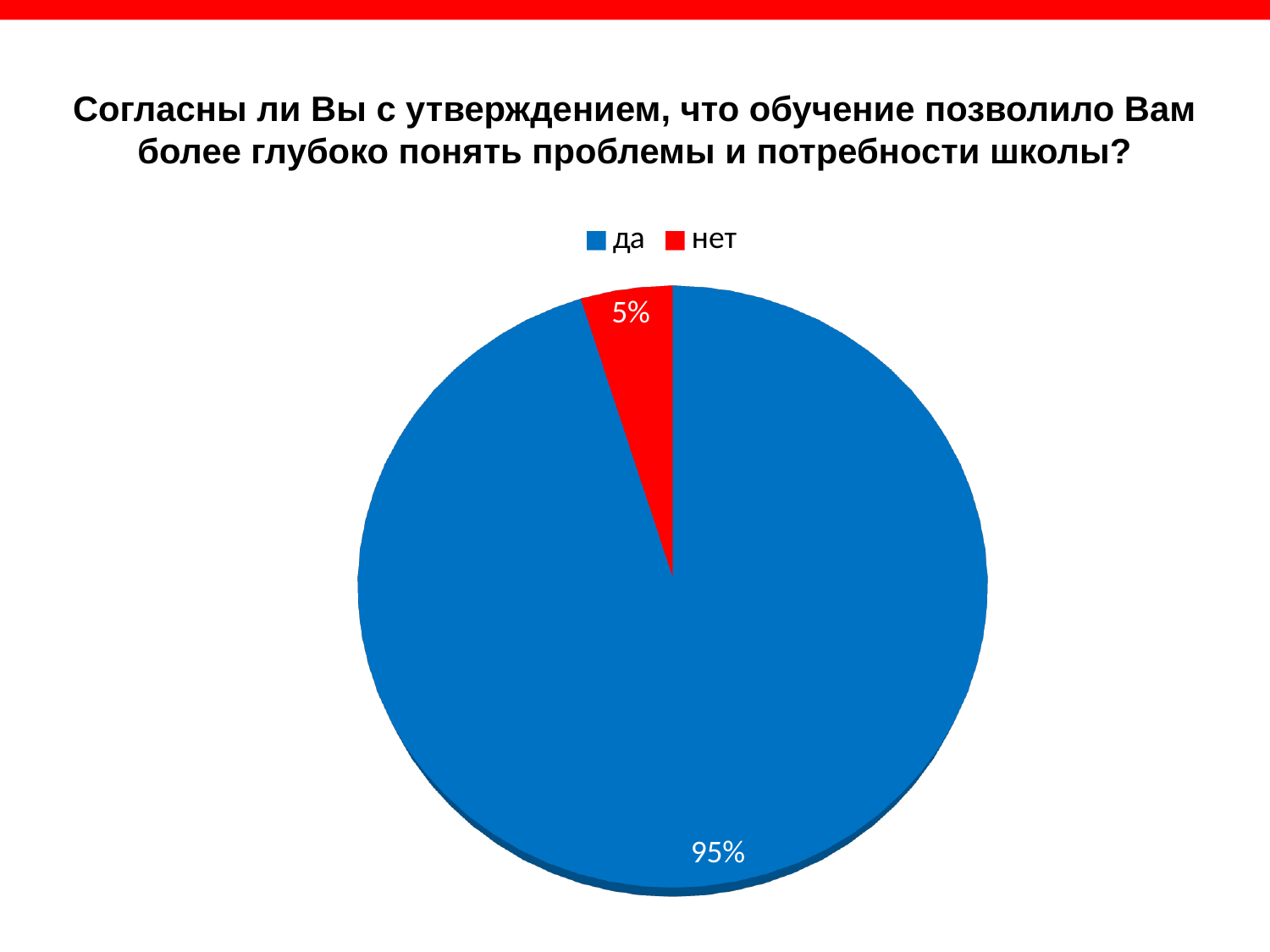
How many categories does the pie chart show? 2 What colour is the "нет" slice? red Which category has the smallest slice of the pie? нет What is the difference in percentage points between the "да" and "нет" slices? 90 What share of the pie does "нет" represent? 5% How many entries does the legend list? 2 What share of the pie does "да" represent? 95% What kind of chart is shown on the slide? pie chart What colour is the "да" slice? blue Which category has the largest slice of the pie? да Which is larger, the "да" slice or the "нет" slice? да